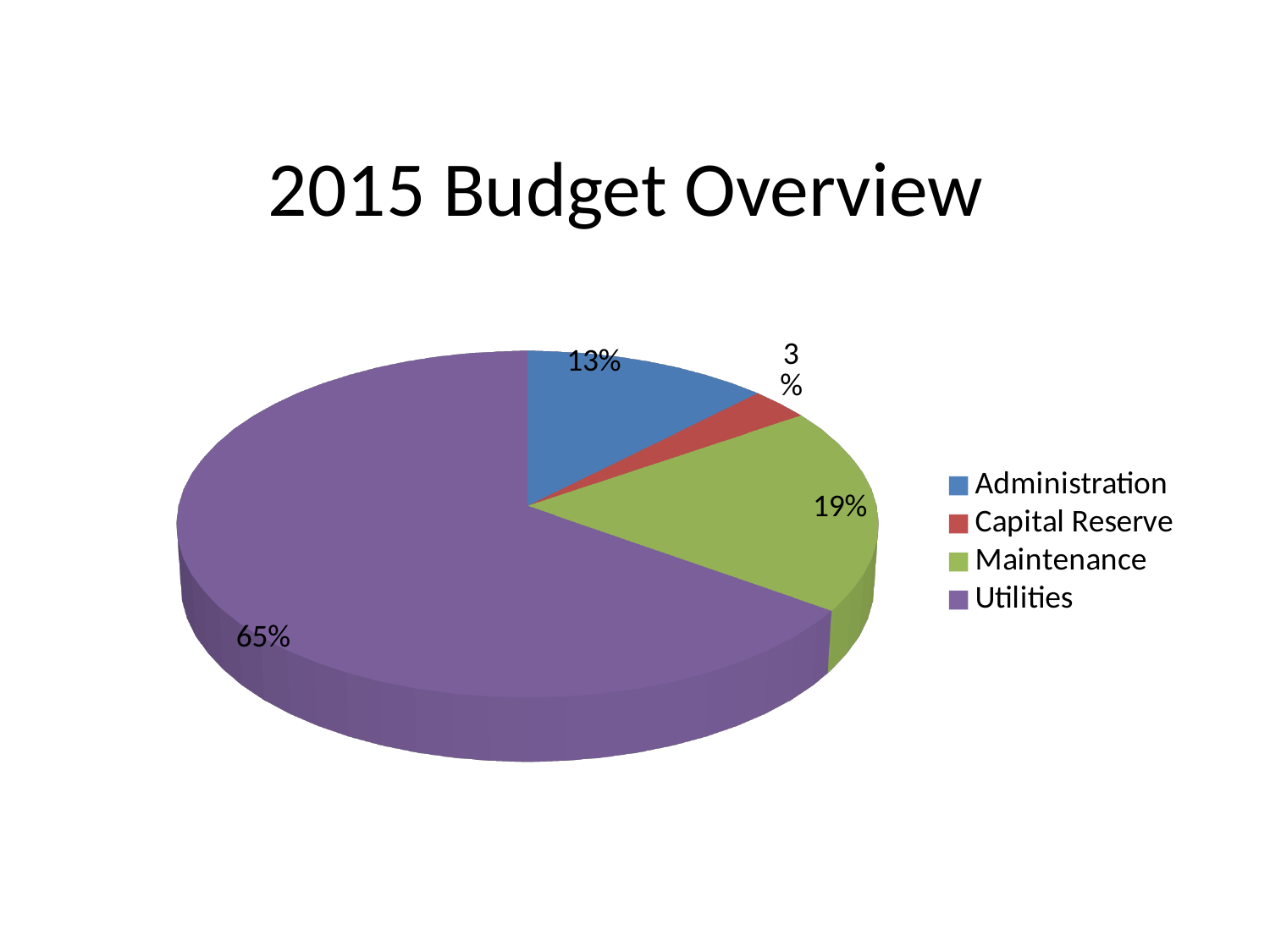
What share of the pie does Maintenance take? 19% Which category has the smallest slice of the pie? Capital Reserve How many categories does the pie chart show? 4 What share of the pie does Capital Reserve take? 3% What share of the pie does Administration take? 13% Which is larger, the Administration share or the Maintenance share? Maintenance What is the difference between the Utilities share and the Maintenance share? 46% What colour is the Utilities slice? purple What type of chart is shown on the slide? pie chart What is the title of the chart? 2015 Budget Overview Which category has the largest slice of the pie? Utilities